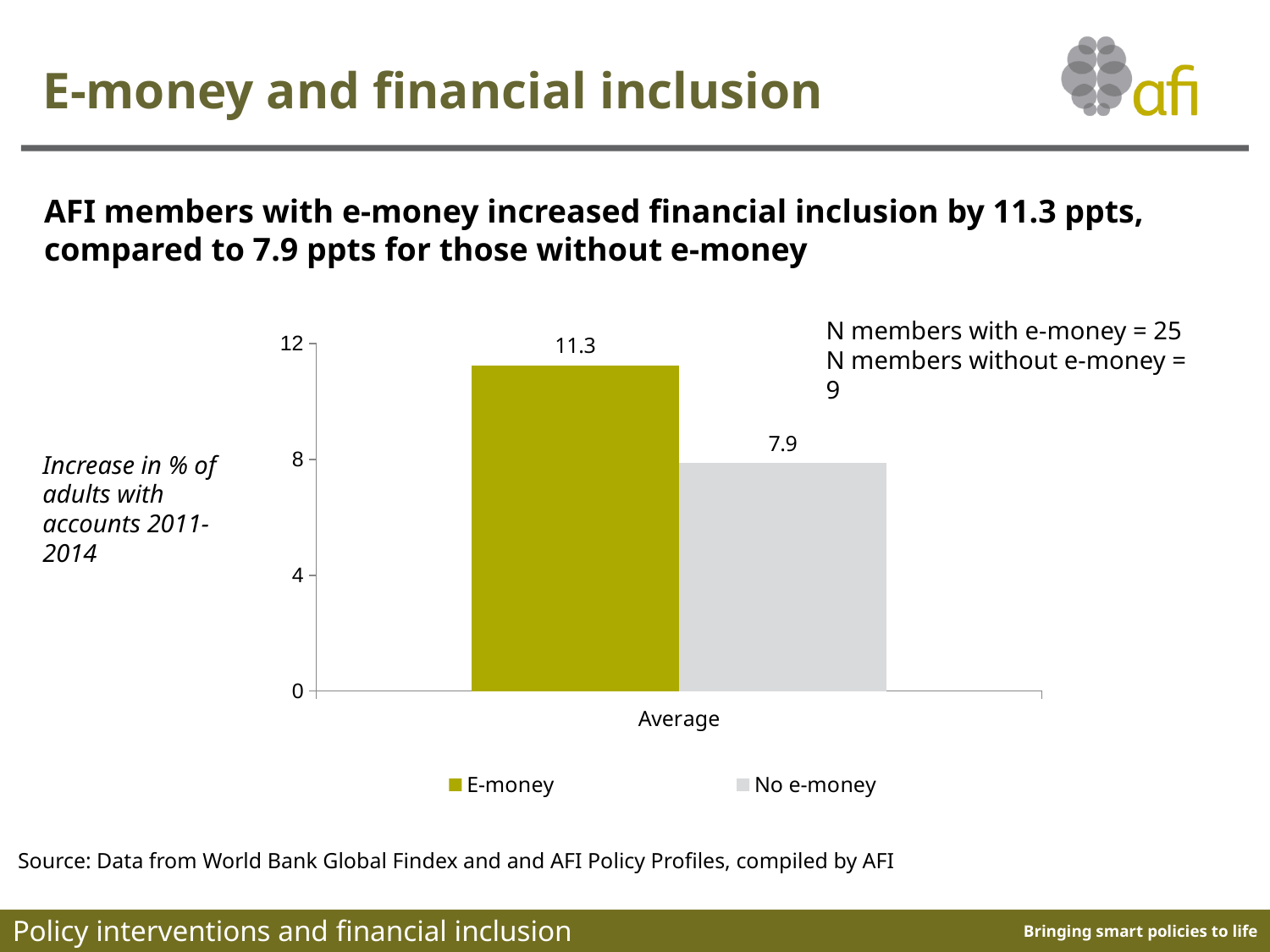
Is the value for No e-money greater or less than 8? less What is the value of the No e-money bar in the chart? 7.9 What is the category label on the x axis of the chart? Average What is the highest value shown on the y axis of the chart? 12 What is the value of the E-money bar in the chart? 11.3 What kind of chart is shown on the slide? Bar chart Which series has the lowest value in the chart? No e-money How many series does the legend list? 2 Which series has the higher value in the chart, E-money or No e-money? E-money What is the difference between the E-money and No e-money values? 3.4 How many categories are shown on the x axis of the chart? 1 Is the value for E-money greater or less than 8? greater